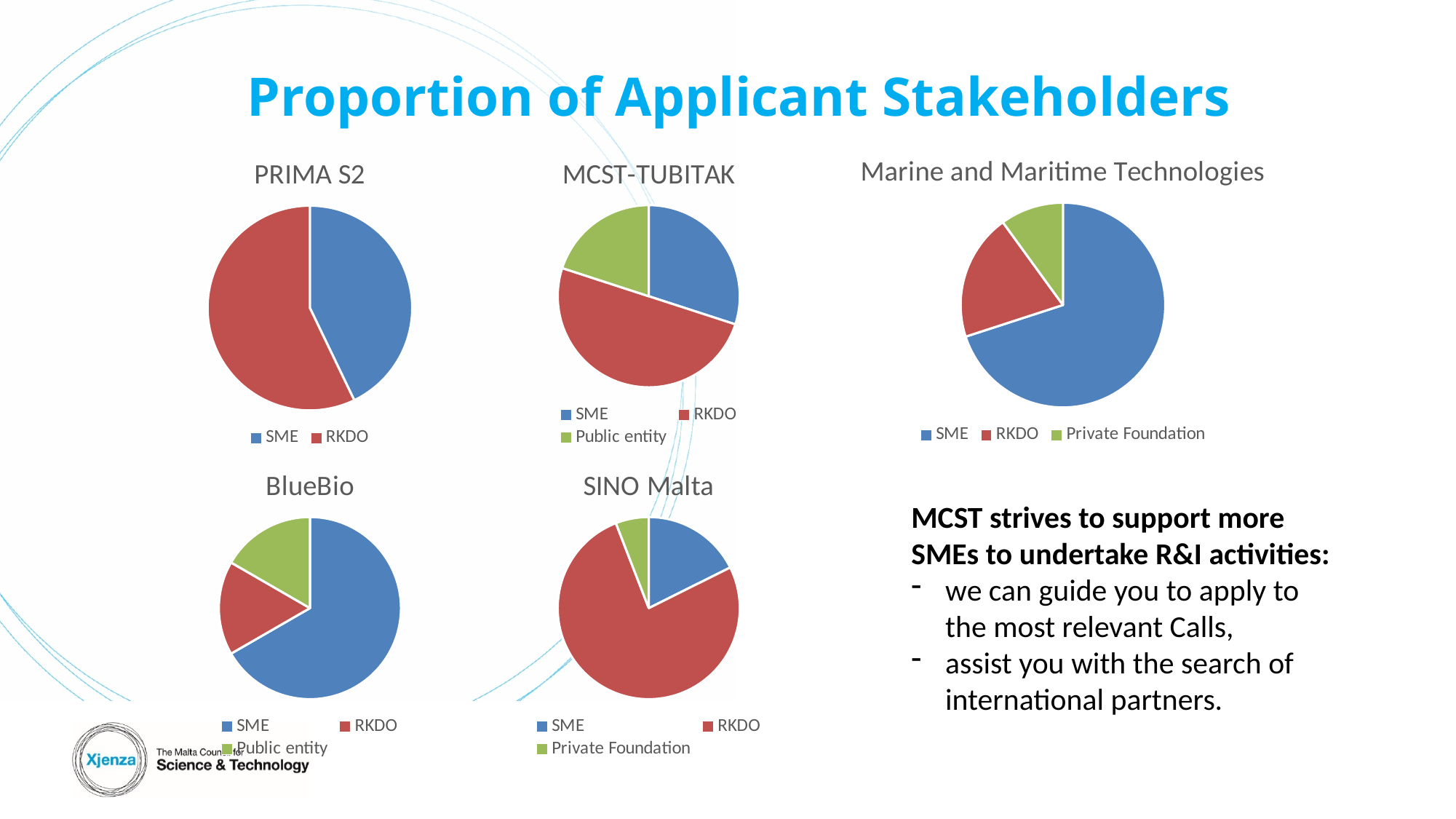
In the Marine and Maritime Technologies chart, which stakeholder type has the smallest share? Private Foundation Which colour represents SME in the pie charts on the slide? Blue In the MCST-TUBITAK chart, which stakeholder type has the largest share? RKDO In the SINO Malta chart, which stakeholder type has the largest share? RKDO What kind of chart is used for PRIMA S2? Pie chart In the PRIMA S2 chart, which stakeholder type has the larger share, SME or RKDO? RKDO How many pie charts are shown on the slide? 5 How many categories does the legend of the PRIMA S2 chart list? 2 How many categories does the legend of the MCST-TUBITAK chart list? 3 In the SINO Malta chart, which stakeholder type has the smallest share? Private Foundation In the Marine and Maritime Technologies chart, which stakeholder type has the largest share? SME